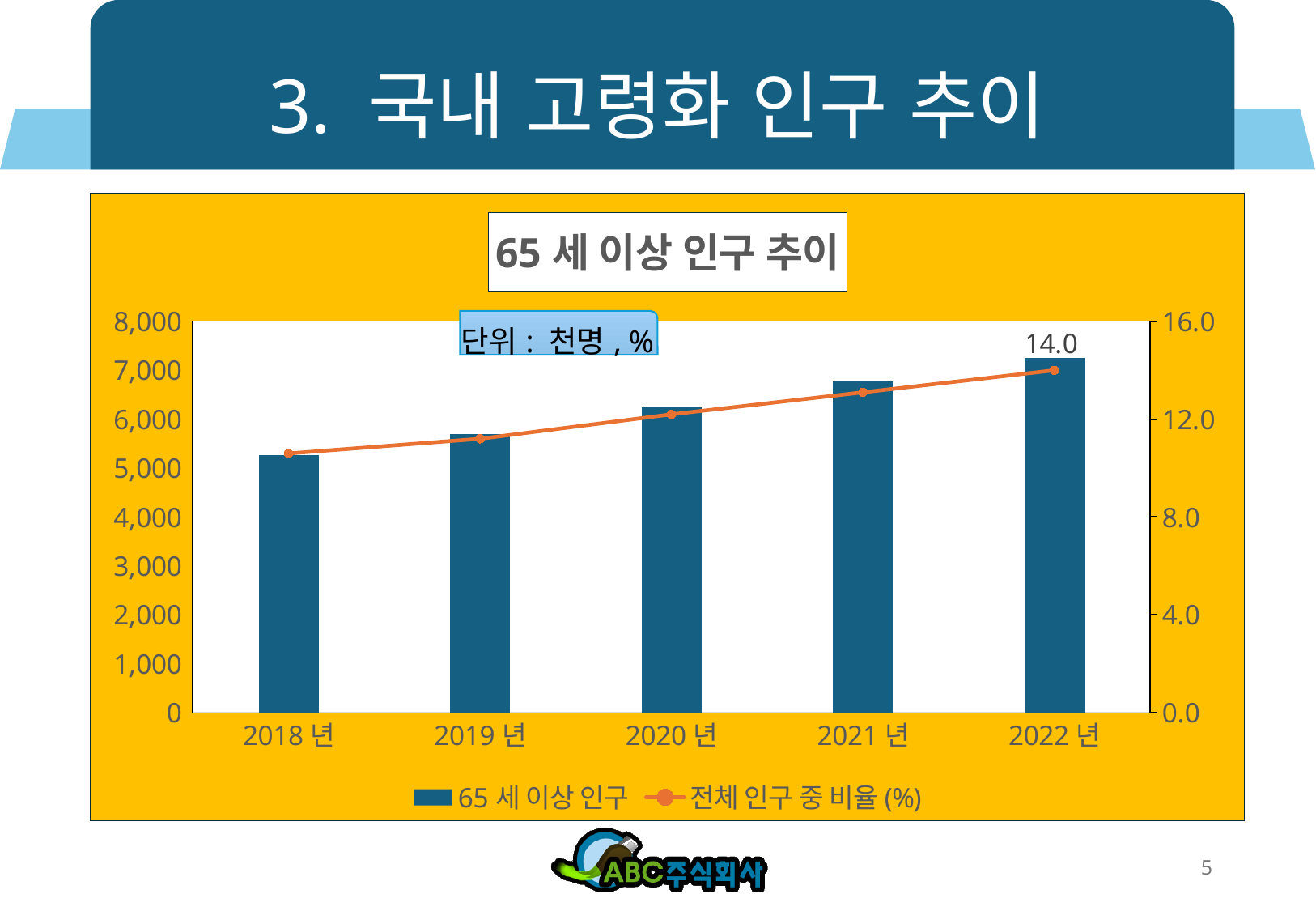
Which year has the highest 65 세 이상 인구 bar? 2022 년 Is the 전체 인구 중 비율 (%) value for 2018 년 greater or less than 12.0? less What is the value of 전체 인구 중 비율 (%) for 2022 년? 14.0 Do the 65 세 이상 인구 bars rise or fall from 2018 년 to 2022 년? rise Which year has the lowest 65 세 이상 인구 bar? 2018 년 Is the 65 세 이상 인구 bar for 2022 년 greater or less than 7,000? greater Which is larger, the 65 세 이상 인구 bar for 2021 년 or for 2019 년? 2021 년 What kind of chart is shown on the slide? A bar chart combined with a line chart How many years are shown on the x axis of the chart? 5 Is the 65 세 이상 인구 bar for 2018 년 greater or less than 6,000? less What is the title of the chart? 65 세 이상 인구 추이 How many series does the chart legend list? 2